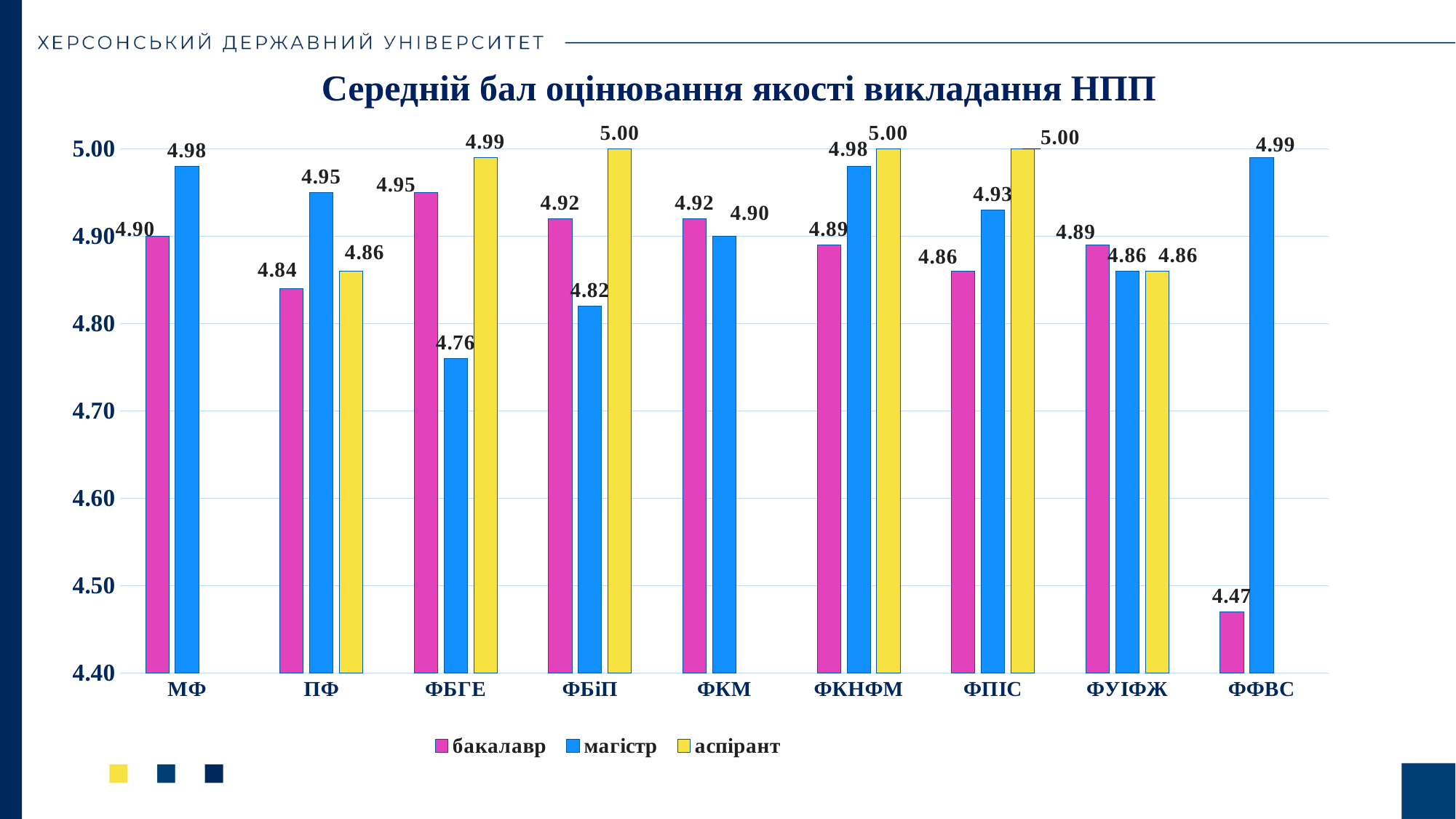
Which is larger for ФБГЕ: the бакалавр value or the магістр value? бакалавр What kind of chart is shown on the slide? bar chart Which faculty has the lowest бакалавр value? ФФВС How many series does the legend list? 3 Is the бакалавр value for ФФВС greater or less than 4.50? less Which faculty has the highest магістр value? ФФВС What is the аспірант value for ПФ? 4.86 How many faculties are shown on the x axis? 9 What is the бакалавр value for ФФВС? 4.47 What is the title of the chart? Середній бал оцінювання якості викладання НПП What is the difference between the магістр and бакалавр values for ФФВС? 0.52 What is the магістр value for ФБГЕ? 4.76